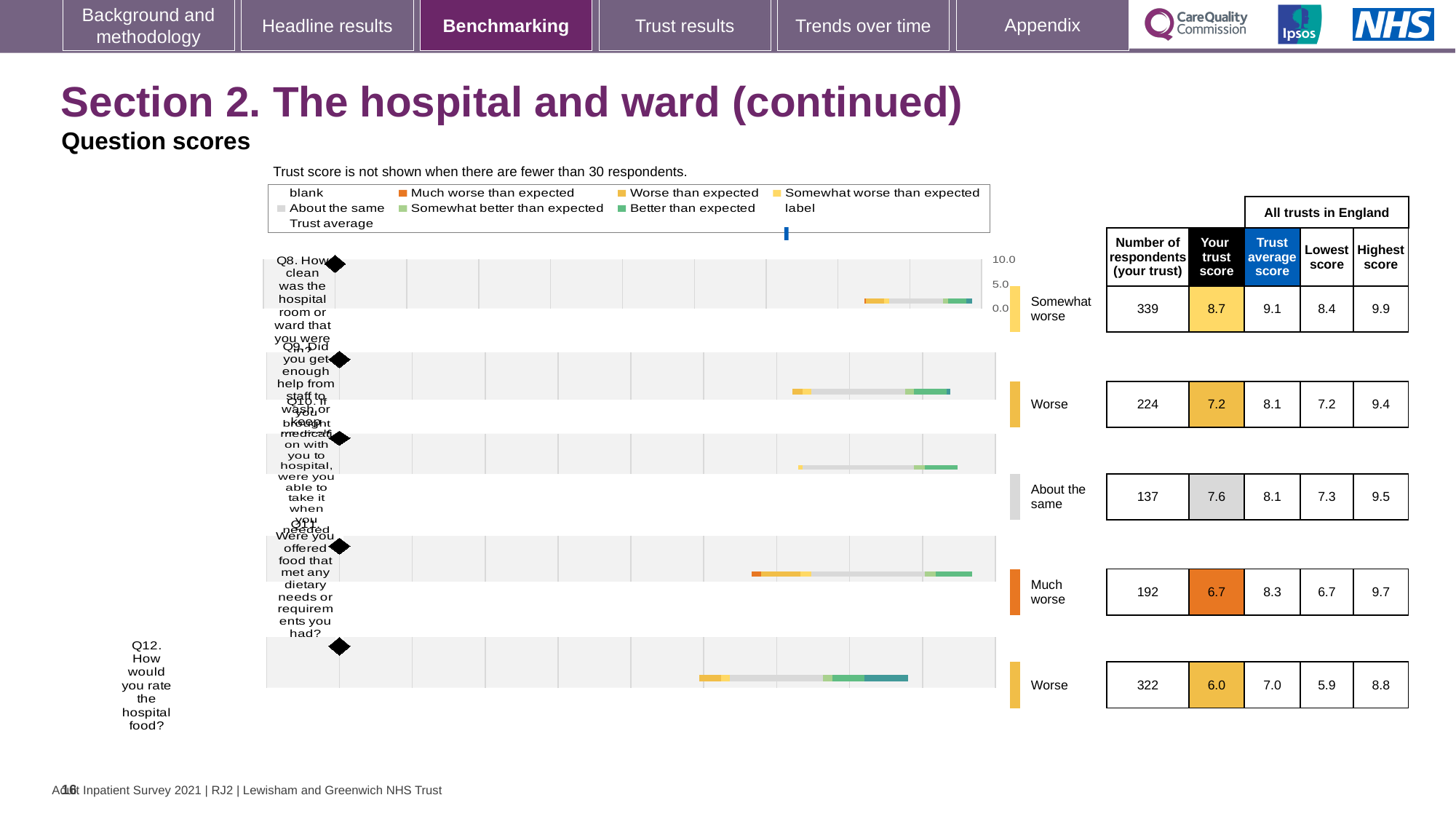
Which has the larger trust score, Q9 or Q10? Q10 What kind of chart is used to show the question scores on this slide? bar chart What is the trust score for Q8 (how clean was the hospital room or ward)? 8.7 Which question has the highest 'Your trust score'? Q8 What is the difference between the trust average score and your trust score for Q8? 0.4 What benchmark category is shown for Q11 (were you offered food that met any dietary needs)? Much worse What is the trust average score for Q11? 8.3 How many respondents answered Q12 (how would you rate the hospital food)? 322 What is the difference between the highest score and the lowest score for Q12? 2.9 How many questions (Q8 to Q12) are plotted in the chart? 5 Which question has the lowest 'Your trust score'? Q12 What is the highest score across all trusts in England for Q12? 8.8